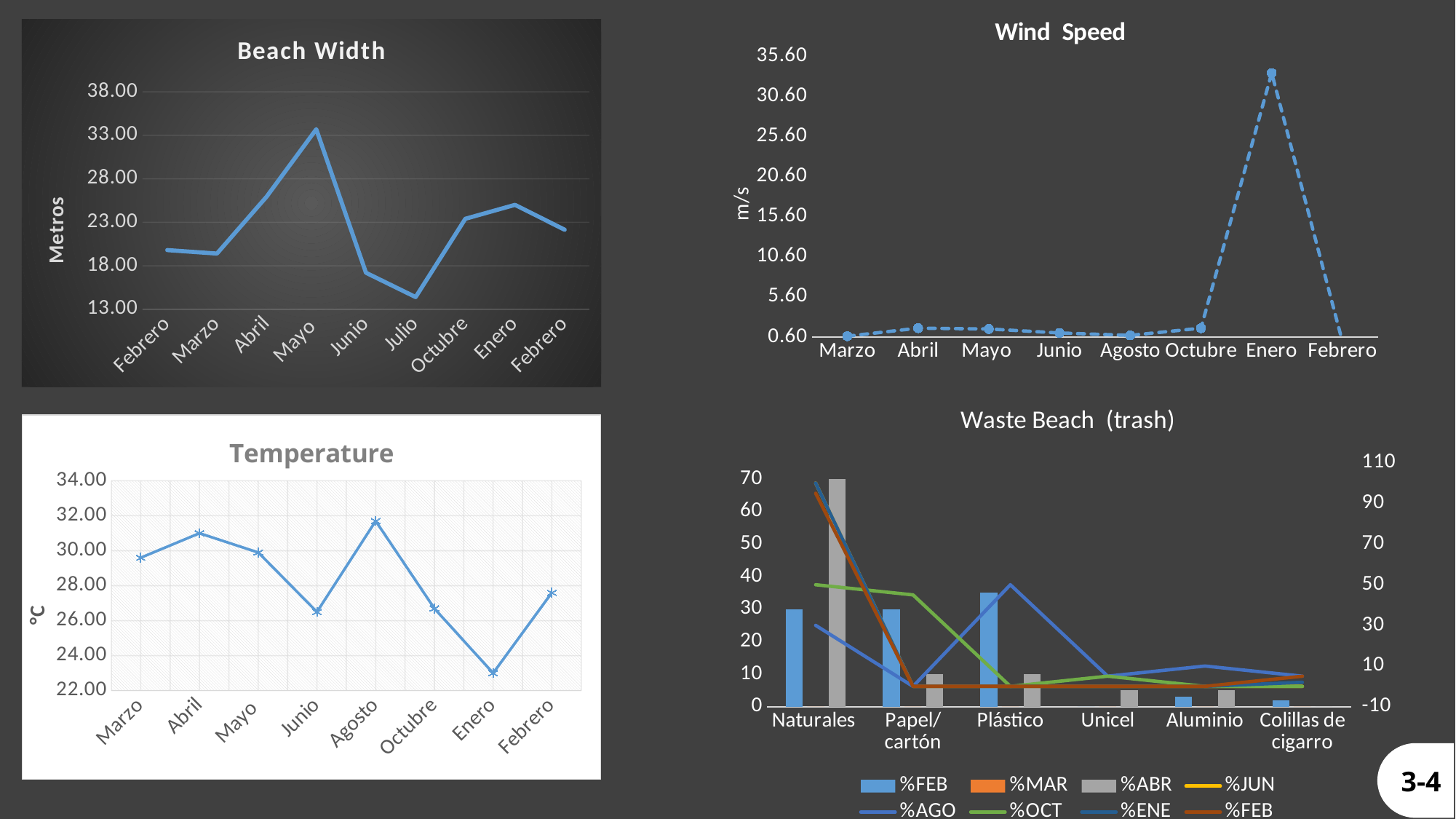
In the Temperature chart, is the value for Abril greater or less than 30.00? greater How many data points are plotted in the Beach Width chart? 9 In the Temperature chart, which month has the lowest temperature? Enero In the Beach Width chart, which month has the highest beach width? Mayo What unit is shown on the vertical axis of the Wind Speed chart? m/s What kind of chart is the Beach Width chart? line chart In the Wind Speed chart, which month has the highest wind speed? Enero How many series does the legend of the Waste Beach (trash) chart list? 8 In the Temperature chart, which month has the highest temperature? Agosto In the Beach Width chart, is the value for Julio greater or less than 18.00? less In the Wind Speed chart, is the value for Enero greater or less than 30.60? greater In the Beach Width chart, which month has the lowest beach width? Julio